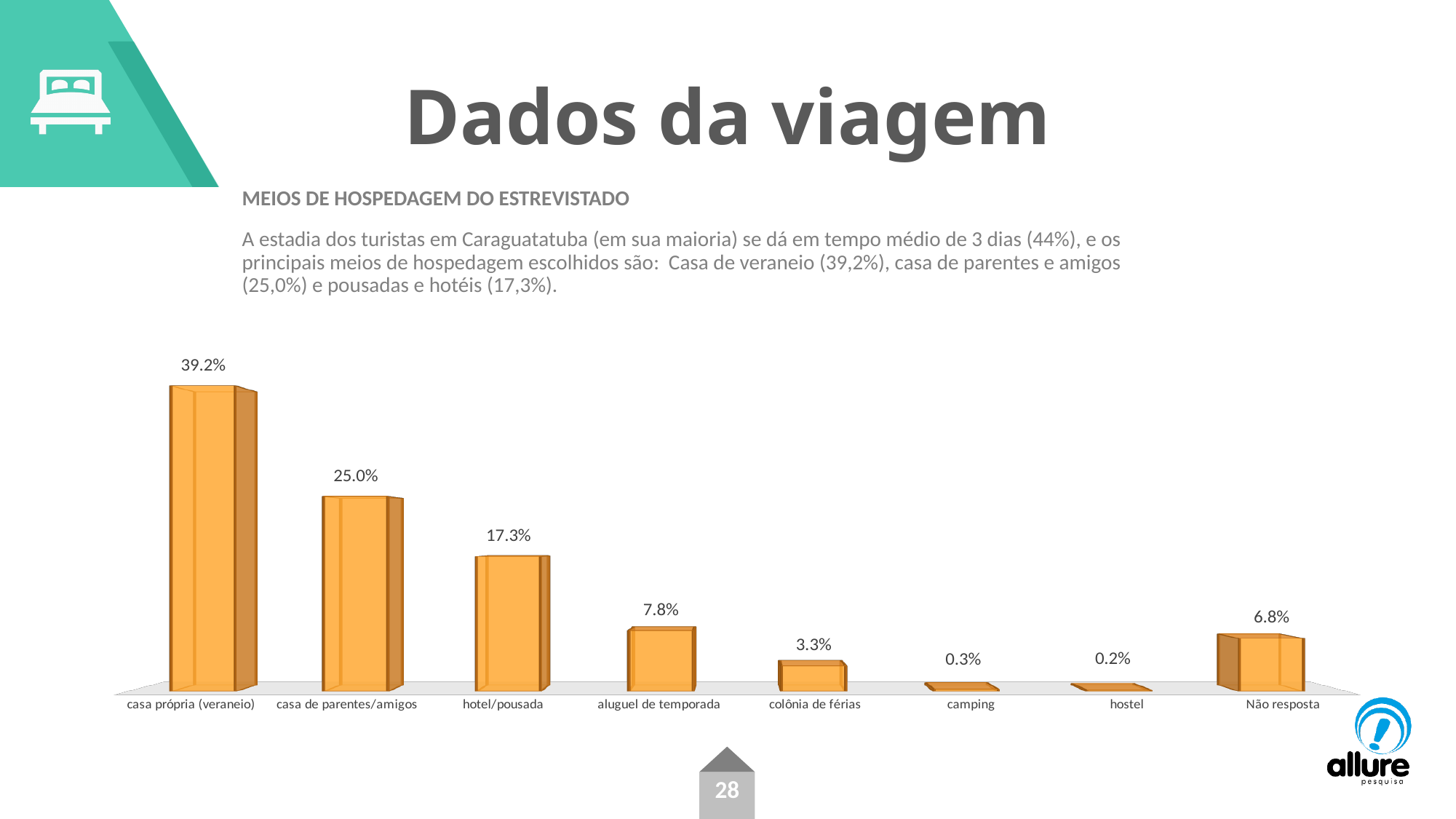
What colour are the bars in the chart? orange What is the value for casa própria (veraneio)? 39.2% Which category has the lowest value? hostel What kind of chart is shown on the slide? bar chart Which is larger, Não resposta or aluguel de temporada? aluguel de temporada Which category has the highest value? casa própria (veraneio) What is the value for Não resposta? 6.8% What is the value for camping? 0.3% What is the value for hotel/pousada? 17.3% What is the difference between casa própria (veraneio) and casa de parentes/amigos? 14.2% How many categories are shown in the chart? 8 What is the difference between aluguel de temporada and colônia de férias? 4.5%